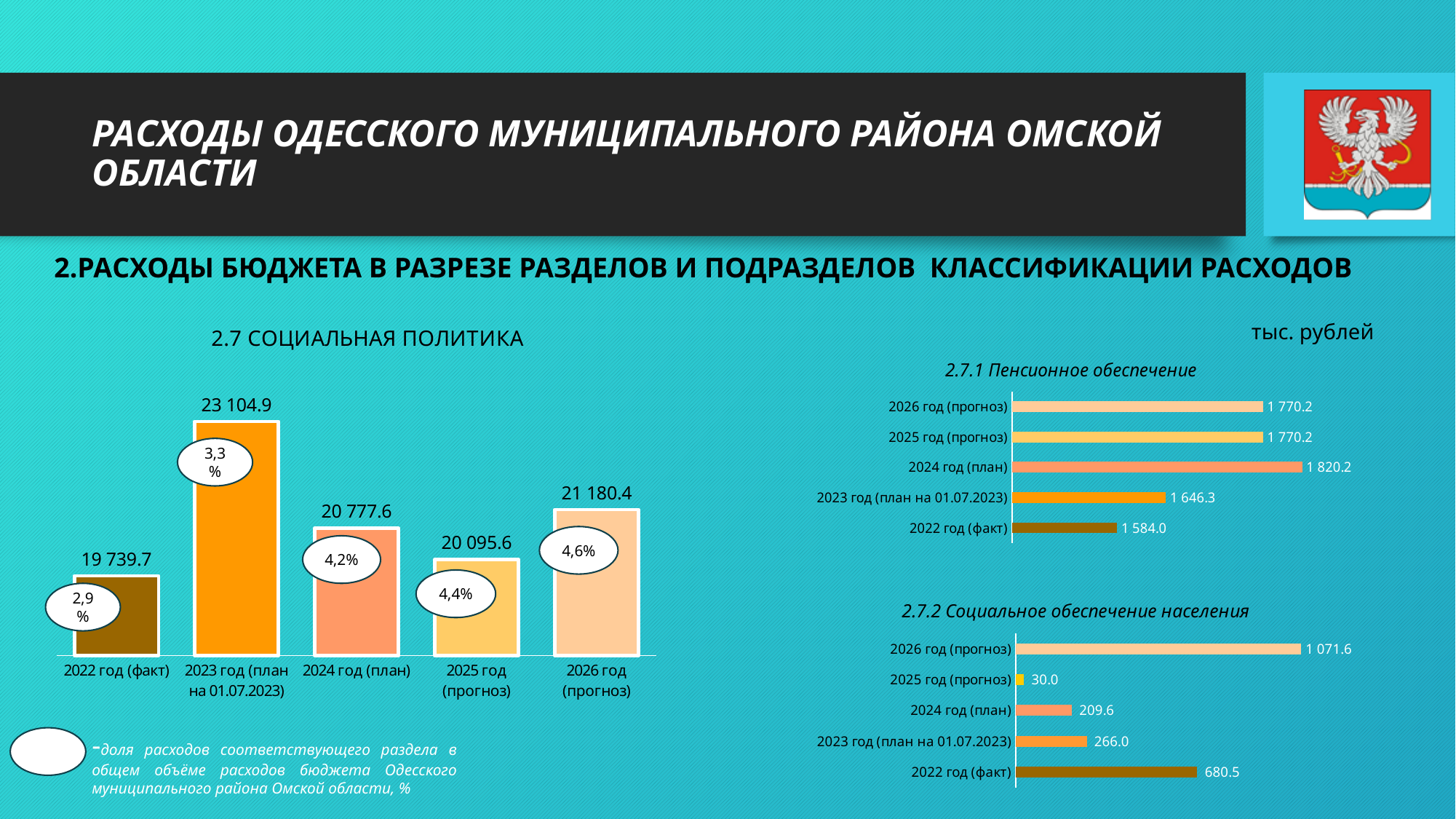
In the chart '2.7.2 Социальное обеспечение населения', what is the difference between the values for 2022 год (факт) and 2024 год (план)? 470.9 In the chart '2.7.1 Пенсионное обеспечение', which year has the lowest value? 2022 год (факт) In the chart '2.7.2 Социальное обеспечение населения', which year has the highest value? 2026 год (прогноз) In the chart '2.7 СОЦИАЛЬНАЯ ПОЛИТИКА', what share percentage is shown in the oval for 2024 год (план)? 4,2% In the chart '2.7.2 Социальное обеспечение населения', which is larger: the value for 2022 год (факт) or 2023 год (план на 01.07.2023)? 2022 год (факт) In the chart '2.7.1 Пенсионное обеспечение', what is the value for 2024 год (план)? 1 820.2 In the chart '2.7.2 Социальное обеспечение населения', what is the value for 2025 год (прогноз)? 30.0 In the chart '2.7 СОЦИАЛЬНАЯ ПОЛИТИКА', what is the difference between the values for 2026 год (прогноз) and 2025 год (прогноз)? 1 084.8 In the chart '2.7 СОЦИАЛЬНАЯ ПОЛИТИКА', which year has the lowest value? 2022 год (факт) What kind of chart is '2.7 СОЦИАЛЬНАЯ ПОЛИТИКА'? bar chart In the chart '2.7 СОЦИАЛЬНАЯ ПОЛИТИКА', what is the value for 2023 год (план на 01.07.2023)? 23 104.9 In the chart '2.7.1 Пенсионное обеспечение', how many bars are shown? 5